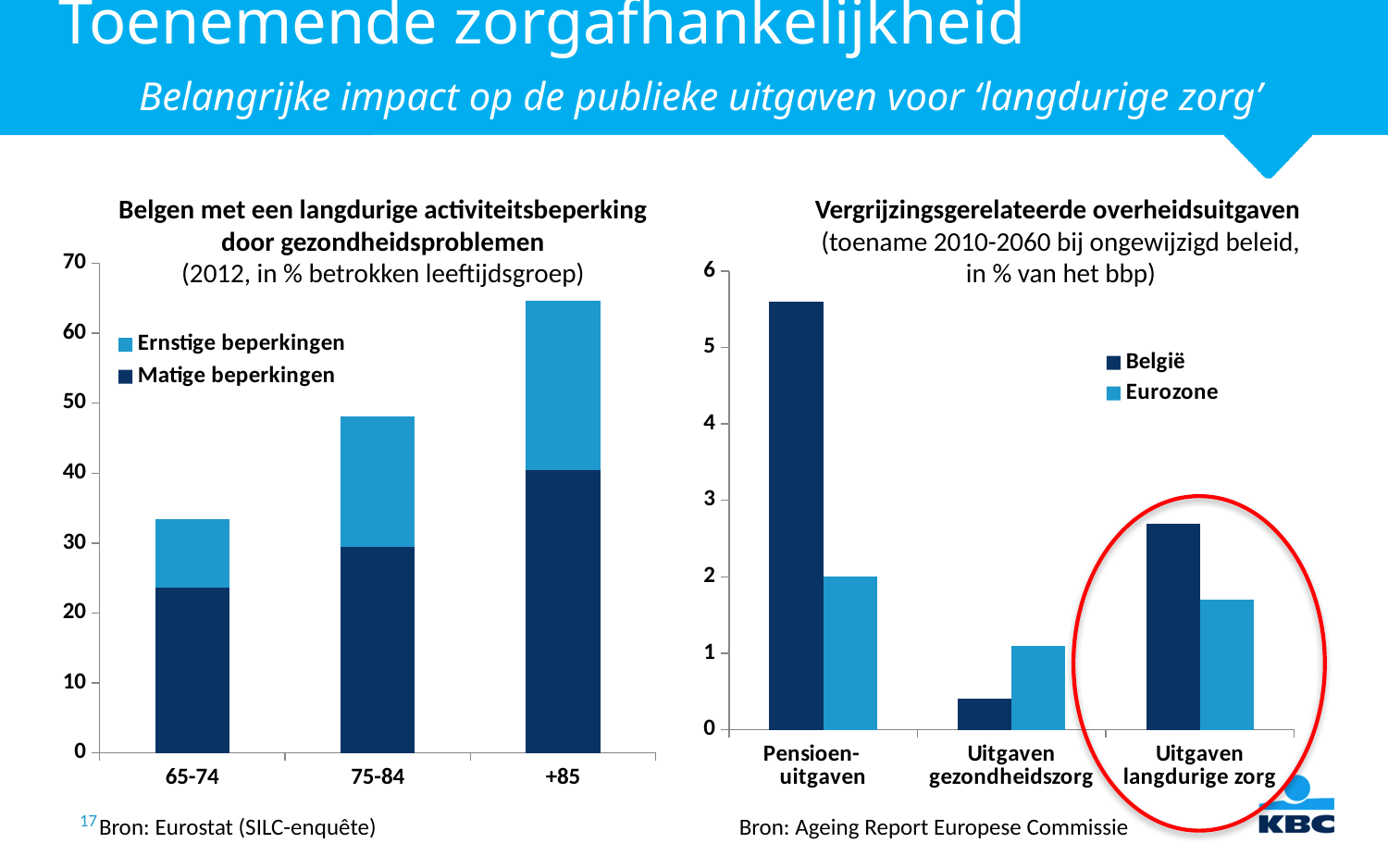
In the right chart, is the value for België under Pensioenuitgaven greater or less than 5? greater In the left chart, is the total value for +85 greater or less than 60? greater In the right chart, for Uitgaven langdurige zorg, which is larger: België or Eurozone? België In the right chart, which series does the legend list besides België? Eurozone What kind of chart is the left chart, 'Belgen met een langdurige activiteitsbeperking door gezondheidsproblemen'? Stacked bar chart In the right chart, which category has the lowest value for België? Uitgaven gezondheidszorg In the left chart, is the total value for 65-74 greater or less than 30? greater In the left chart, do the total bar heights rise or fall from 65-74 to +85? rise In the right chart, 'Vergrijzingsgerelateerde overheidsuitgaven', which category has the highest value for België? Pensioenuitgaven In the left chart, which age group has the highest total bar? +85 In the left chart, how many series does the legend list? 2 In the left chart, how many age groups are shown on the x axis? 3